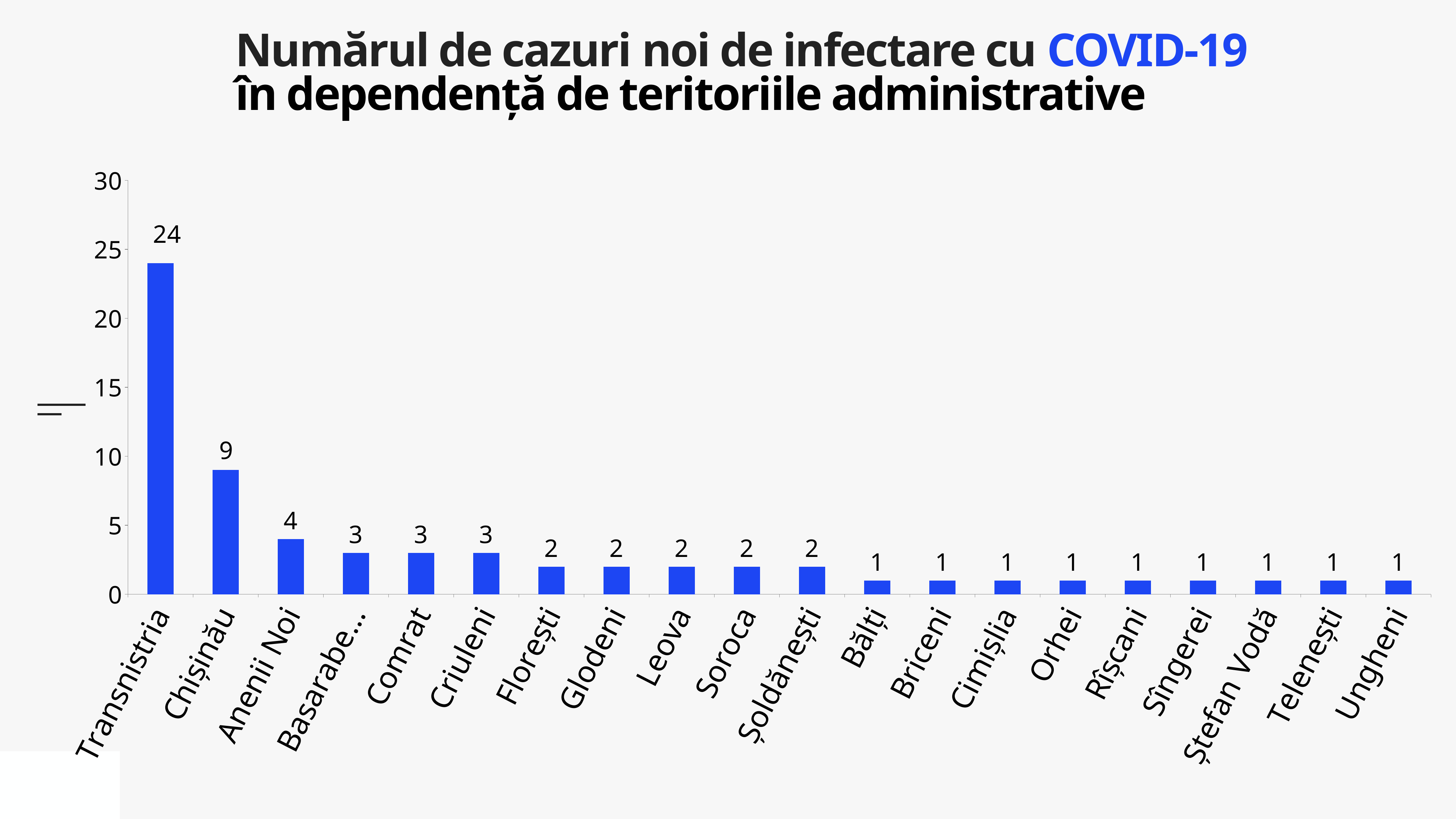
What is the difference between the values for Comrat and Florești? 1 Is the value for Transnistria greater or less than 20? greater What is the value for Chișinău? 9 Which category has the highest value? Transnistria What is the difference between the values for Transnistria and Chișinău? 15 What is the value for Anenii Noi? 4 What is the value for Ungheni? 1 Which is larger, the value for Chișinău or the value for Anenii Noi? Chișinău How many categories are shown on the x axis? 20 What is the value for Transnistria? 24 What kind of chart is shown on the slide? bar chart What is the value for Soroca? 2